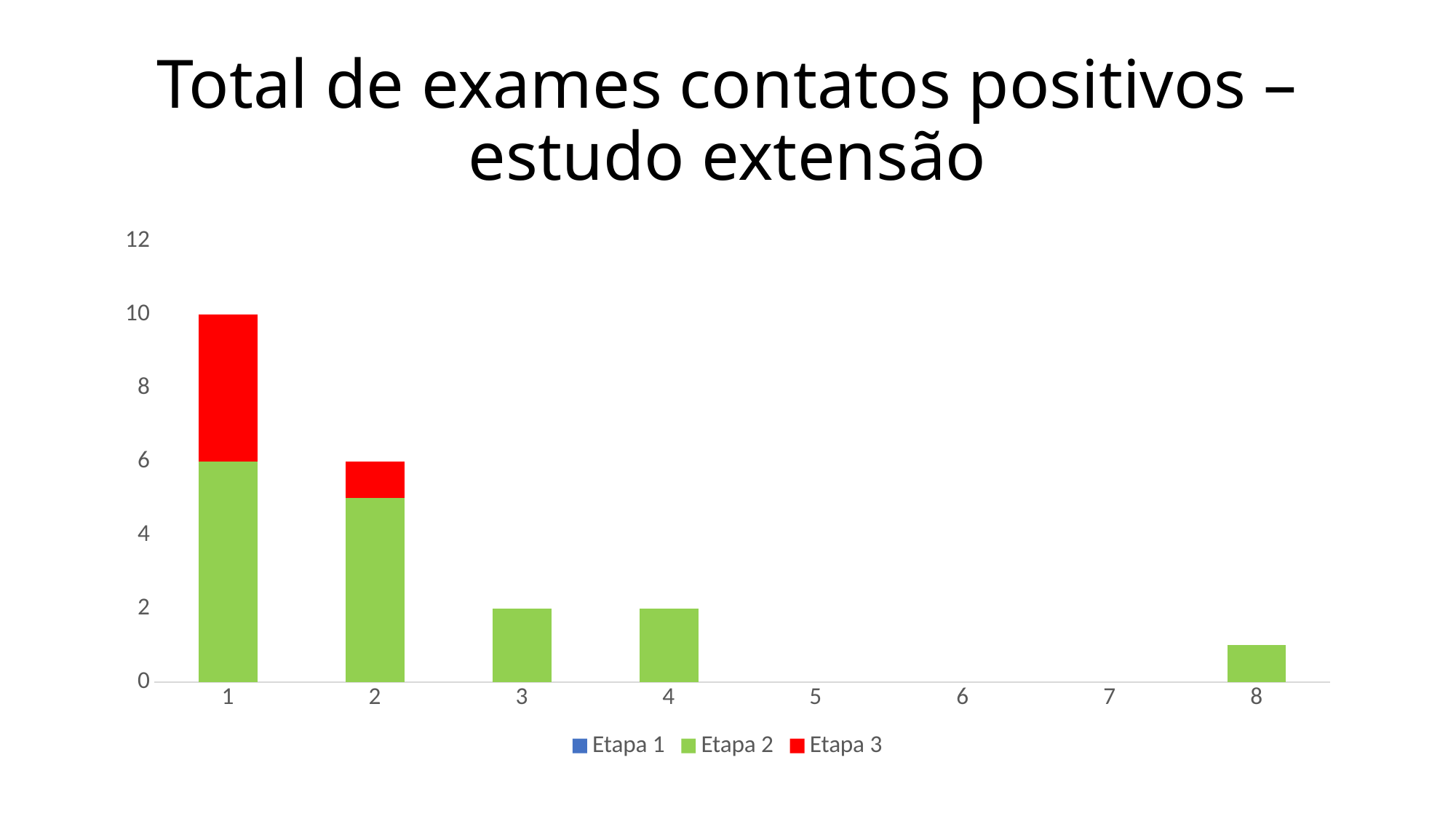
What kind of chart is shown on the slide? Stacked bar chart How many categories are shown on the x axis? 8 What is the total height of the stacked bar for category 1? 10 What is the value of Etapa 2 for category 1? 6 Which colour represents Etapa 3 in the legend? Red What is the value of Etapa 2 for category 3? 2 Is the value for category 8 greater or less than 2? less What is the difference between the total bar for category 1 and the total bar for category 2? 4 How many series does the legend list? 3 What is the total height of the stacked bar for category 2? 6 Which is larger, the total bar for category 1 or for category 2? Category 1 Which category has the highest total bar? 1